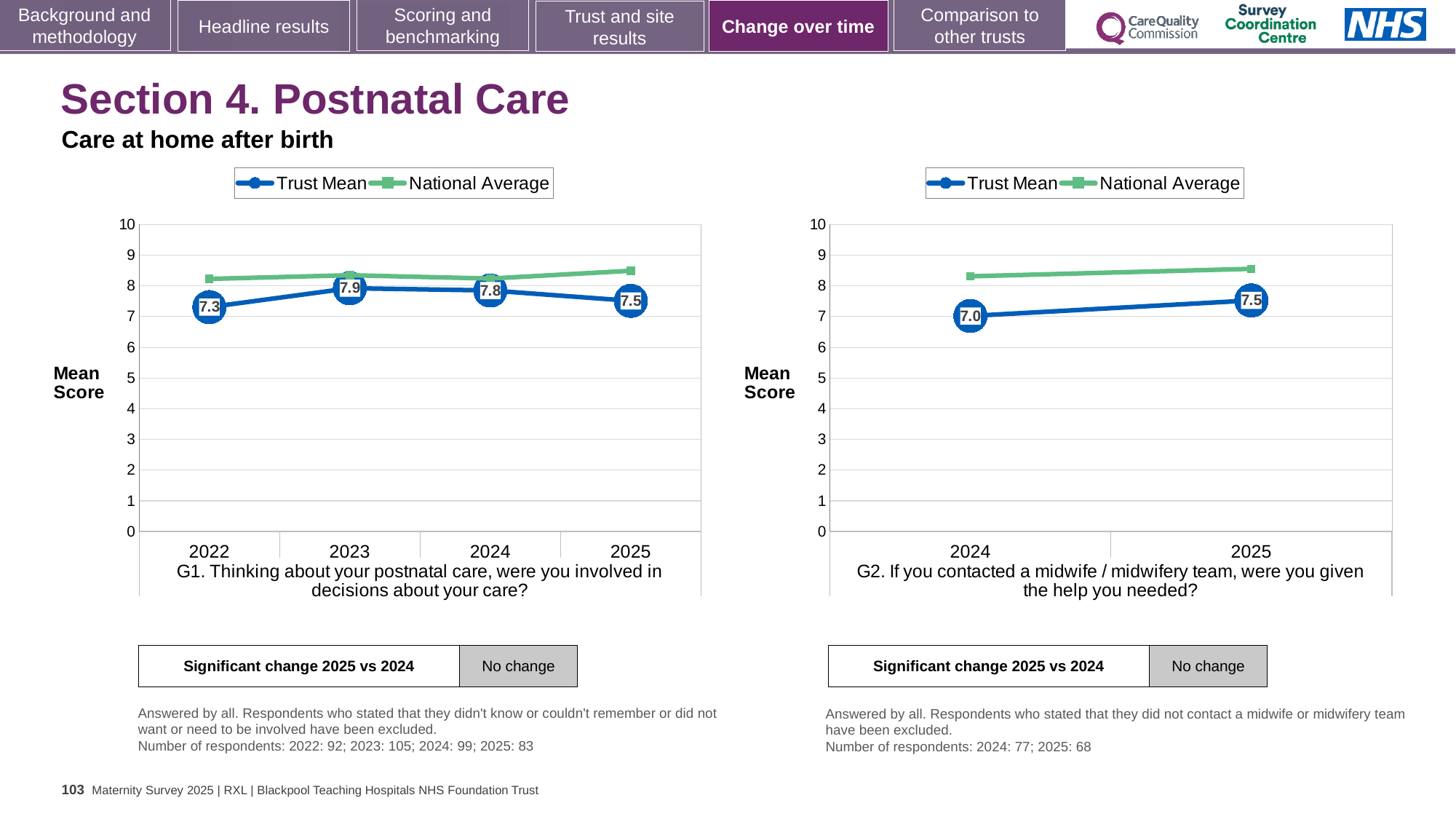
In the left chart (G1), is the Trust Mean higher in 2023 or in 2025? 2023 How many series does the legend of the right chart (G2) list? 2 In the left chart (G1), what is the Trust Mean for 2022? 7.3 In the right chart (G2), is the National Average for 2025 greater or less than 8? greater In the right chart (G2), what is the Trust Mean for 2024? 7.0 In the left chart (G1), what is the Trust Mean for 2025? 7.5 In the right chart (G2), does the Trust Mean rise or fall from 2024 to 2025? Rise In the left chart (G1), which year has the lowest Trust Mean? 2022 In the left chart (G1), which year has the highest Trust Mean? 2023 What kind of chart is the left chart (G1)? Line chart In the right chart (G2), what is the difference between the Trust Mean for 2025 and 2024? 0.5 How many years are plotted on the x axis of the left chart (G1)? 4